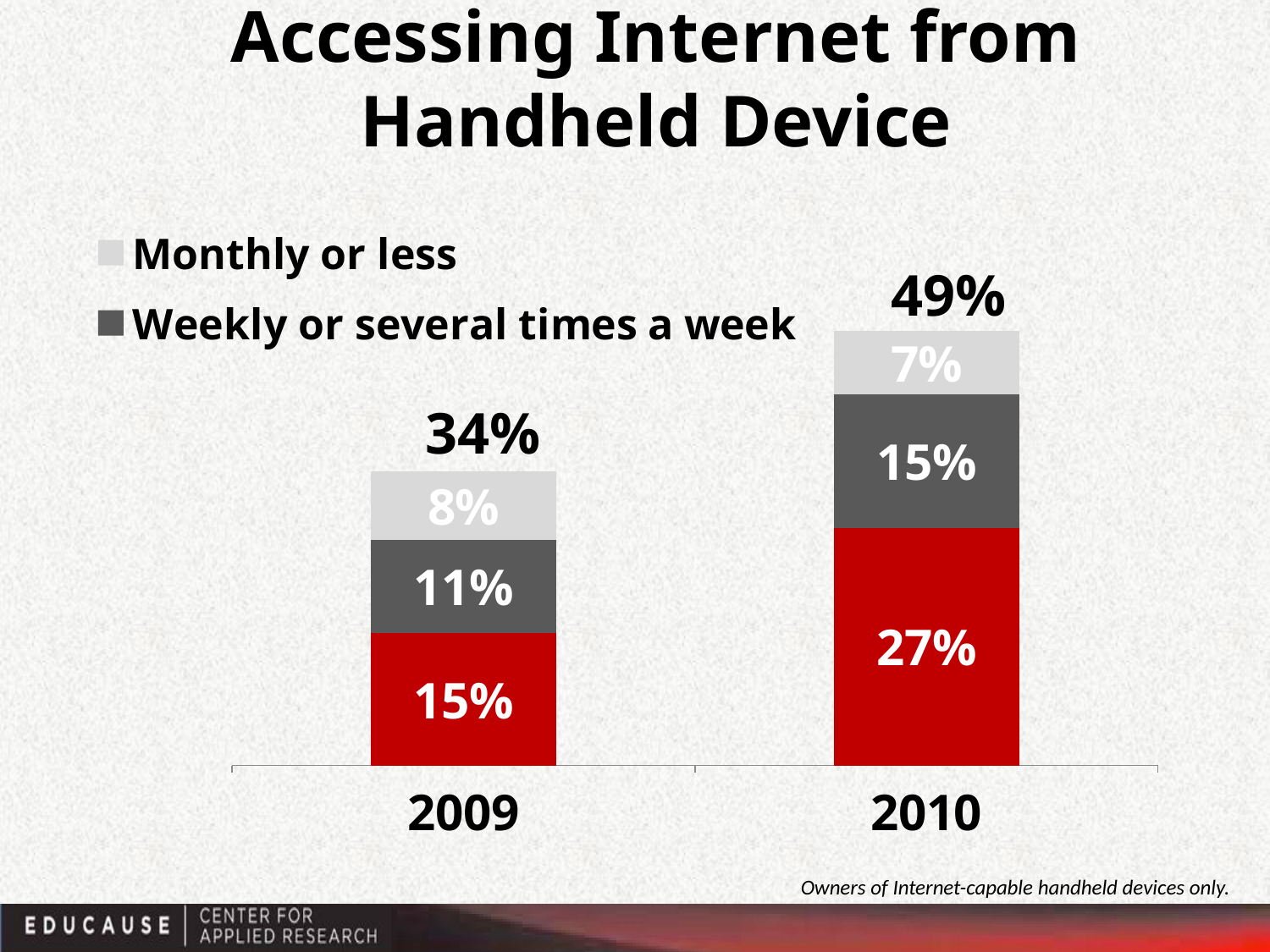
How many series does the legend list? 2 Which year has the higher total? 2010 What is the value for "Weekly or several times a week" in 2009? 11% What type of chart is shown on the slide? stacked bar chart How many years are shown on the x axis? 2 What is the value for "Monthly or less" in 2009? 8% What value is shown in the red segment of the 2010 bar? 27% What is the value for "Weekly or several times a week" in 2010? 15% What is the total shown above the 2009 bar? 34% What is the total shown above the 2010 bar? 49% What is the value for "Monthly or less" in 2010? 7% What is the difference between the 2010 total and the 2009 total? 15%